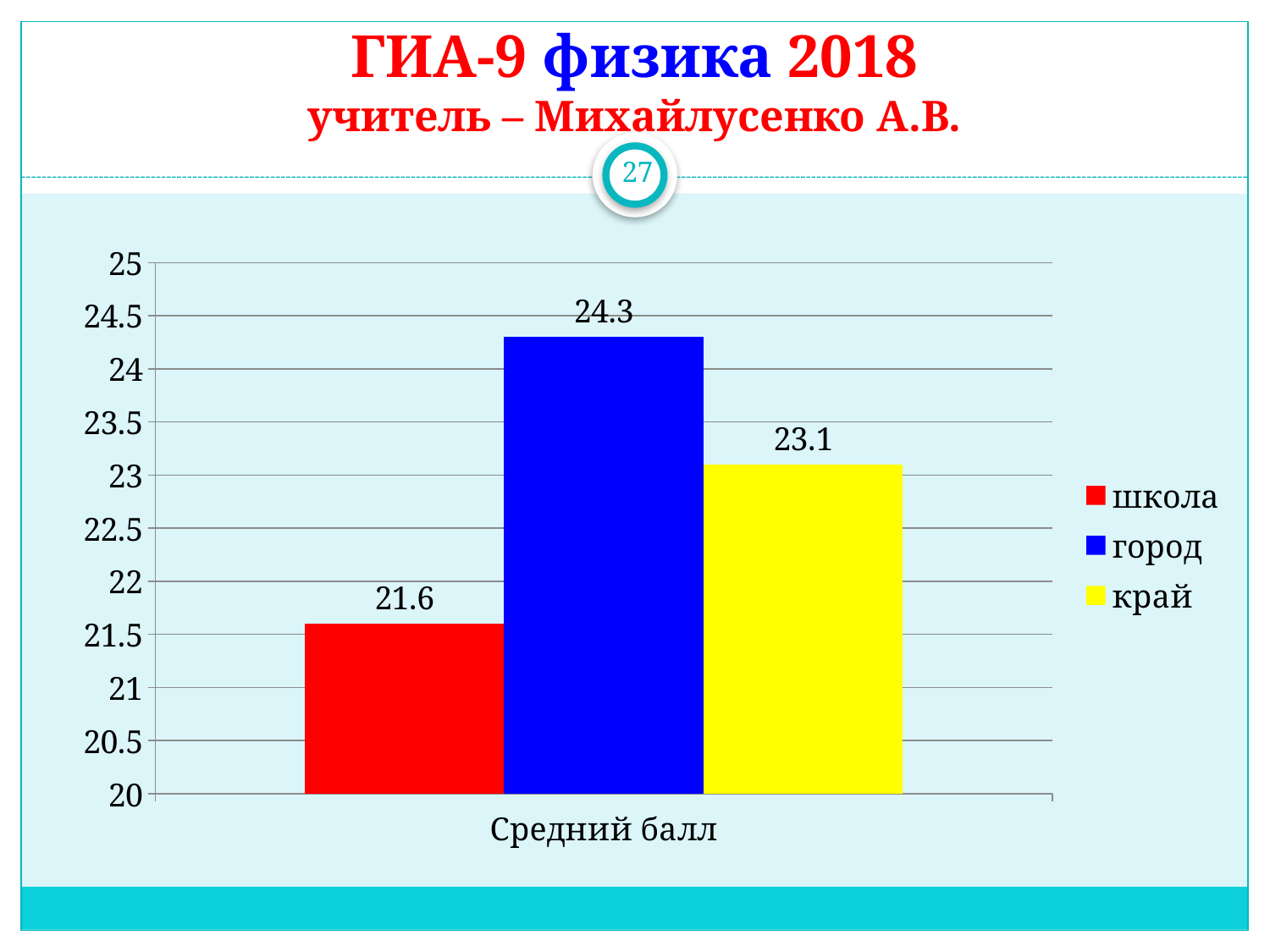
What is the difference between the values for город and школа? 2.7 What is the value for школа in the Средний балл chart? 21.6 What colour is the bar for город? blue What is the difference between the values for край and школа? 1.5 How many series does the legend list? 3 Which series has the highest value? город What is the value for город in the Средний балл chart? 24.3 Is the value for город greater or less than 24? greater Which is larger, the value for край or the value for школа? край What is the value for край in the Средний балл chart? 23.1 Which series has the lowest value? школа What kind of chart is shown on the slide? bar chart